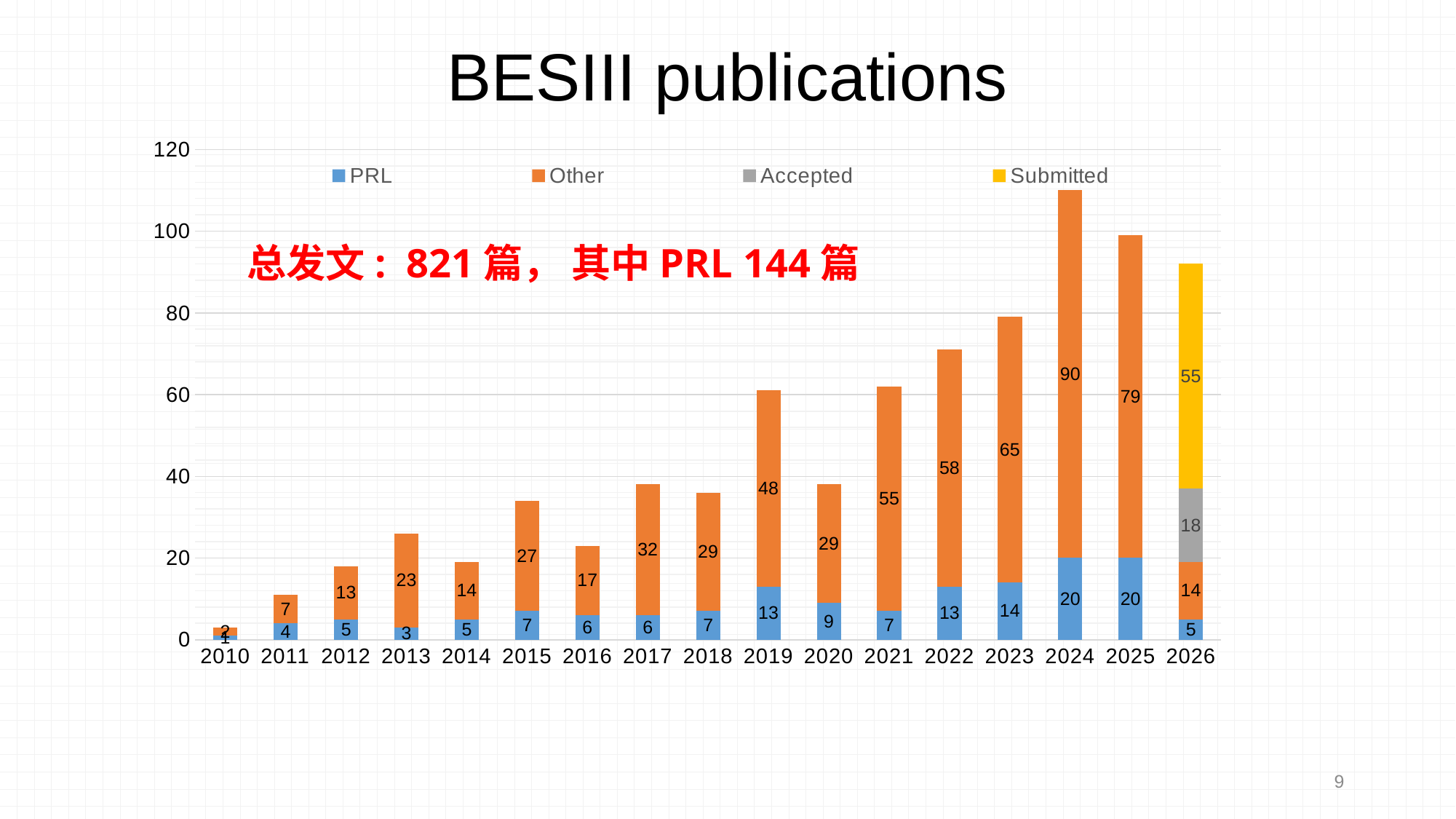
What is the PRL value for 2019? 13 Which year has the highest Other value? 2024 What is the Accepted value for 2026? 18 Which is larger, the Other value for 2021 or for 2022? 2022 How many series does the legend list? 4 What is the Other value for 2024? 90 Which year has the lowest PRL value? 2010 What kind of chart is shown on the slide? Stacked bar chart How many years are shown on the x axis? 17 What is the Submitted value for 2026? 55 What is the total of the stacked bar for 2024? 110 What is the difference between the Other values for 2024 and 2025? 11